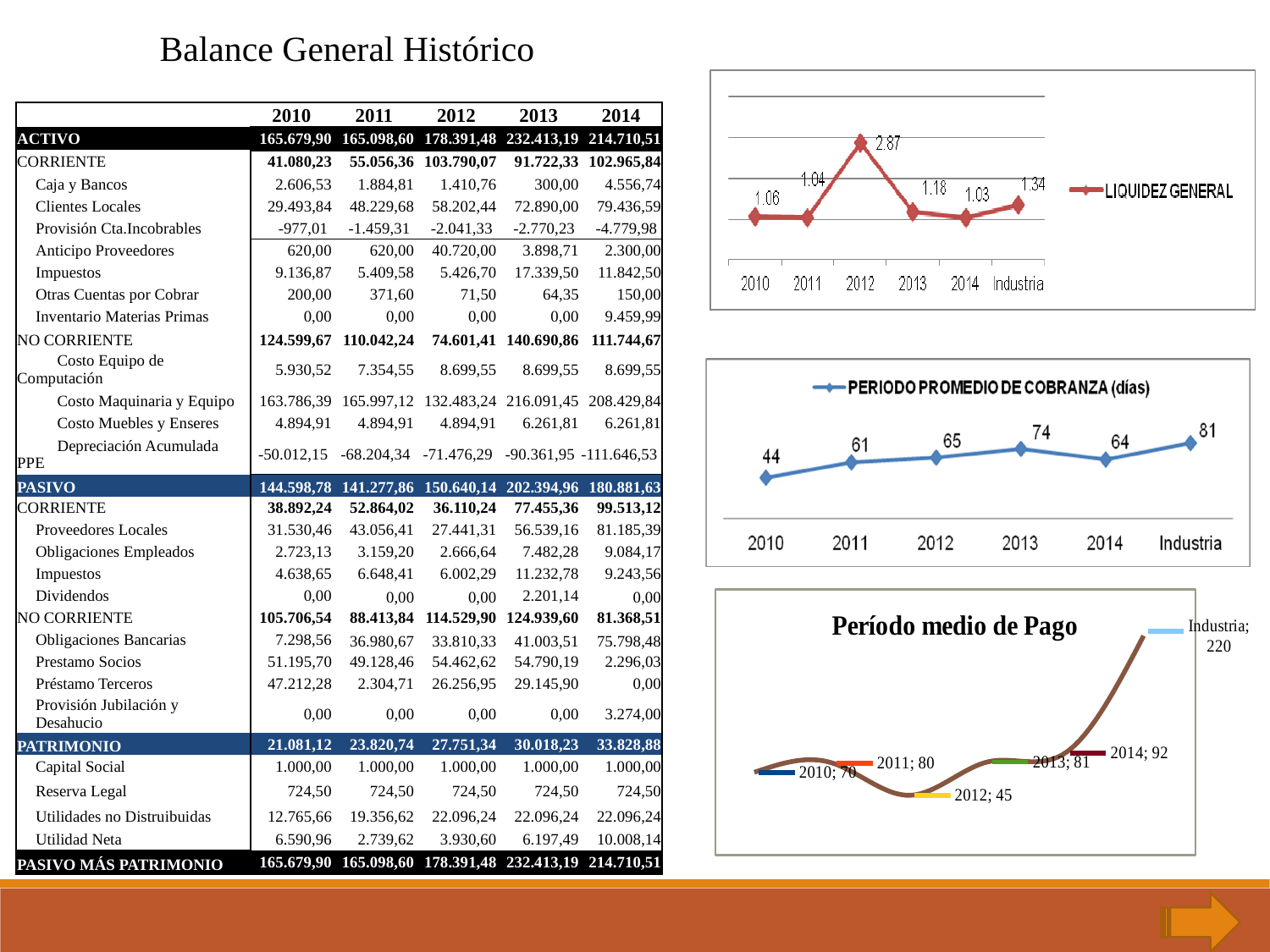
In the PERIODO PROMEDIO DE COBRANZA (días) chart, which category has the lowest value? 2010 In the LIQUIDEZ GENERAL chart, what is the value for Industria? 1.34 In the LIQUIDEZ GENERAL chart, what is the value for 2012? 2.87 In the PERIODO PROMEDIO DE COBRANZA (días) chart, what is the difference between the Industria value and the 2014 value? 17 In the LIQUIDEZ GENERAL chart, which category has the highest value? 2012 In the Período medio de Pago chart, what is the value for Industria? 220 In the PERIODO PROMEDIO DE COBRANZA (días) chart, which is larger, the value for 2012 or the value for 2014? 2012 In the PERIODO PROMEDIO DE COBRANZA (días) chart, what is the value for 2013? 74 In the Período medio de Pago chart, what is the value for 2014? 92 What kind of chart is the PERIODO PROMEDIO DE COBRANZA (días) chart? line chart In the LIQUIDEZ GENERAL chart, how many categories are shown on the x axis? 6 In the LIQUIDEZ GENERAL chart, which category has the lowest value? 2014